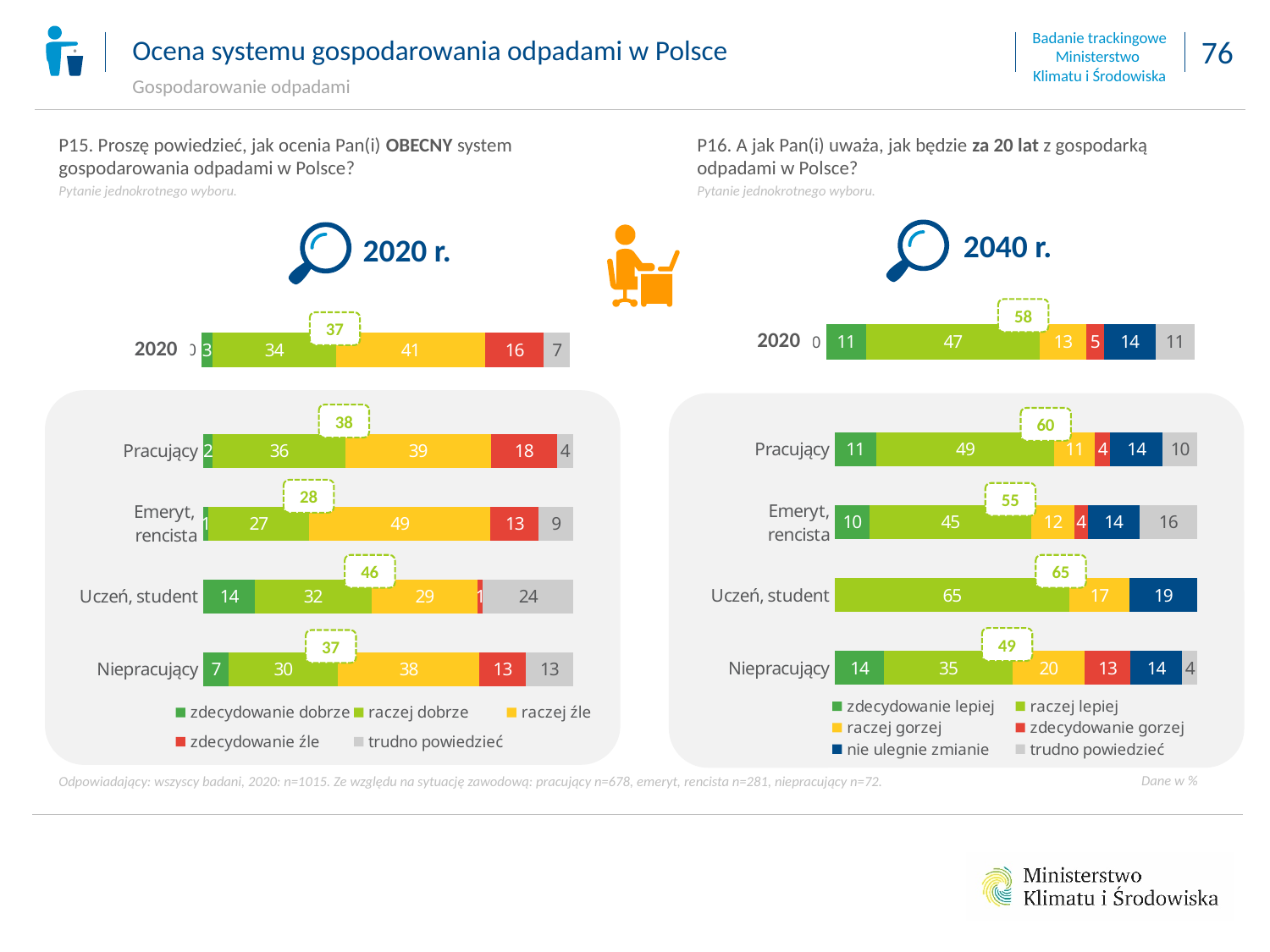
In the left-hand chart (P15, 2020 r.) broken down by occupation, which group has the highest value for 'zdecydowanie źle'? Pracujący In the left-hand chart (P15, 2020 r.) broken down by occupation, what is the difference between the 'raczej dobrze' values for Pracujący and Emeryt, rencista? 9 How many occupation groups are shown in the left-hand chart (P15, 2020 r.) broken down by occupation? 4 In the right-hand chart (P16, 2040 r.) broken down by occupation, which is larger: 'raczej gorzej' for Niepracujący or for Pracujący? Niepracujący In the right-hand chart (P16, 2040 r.) broken down by occupation, what is the value of 'trudno powiedzieć' for Emeryt, rencista? 16 In the top-left bar for 2020 (P15), what is the value of 'raczej źle'? 41 In the left-hand chart (P15, 2020 r.) broken down by occupation, what is the value of 'raczej źle' for Emeryt, rencista? 49 What kind of chart is used for the P15 (2020 r.) breakdown by occupation? Stacked bar chart How many series does the legend of the right-hand chart (P16, 2040 r.) list? 6 In the right-hand chart (P16, 2040 r.) broken down by occupation, what is the value of 'raczej lepiej' for Uczeń, student? 65 In the left-hand chart (P15, 2020 r.) broken down by occupation, what is the value of 'zdecydowanie dobrze' for Uczeń, student? 14